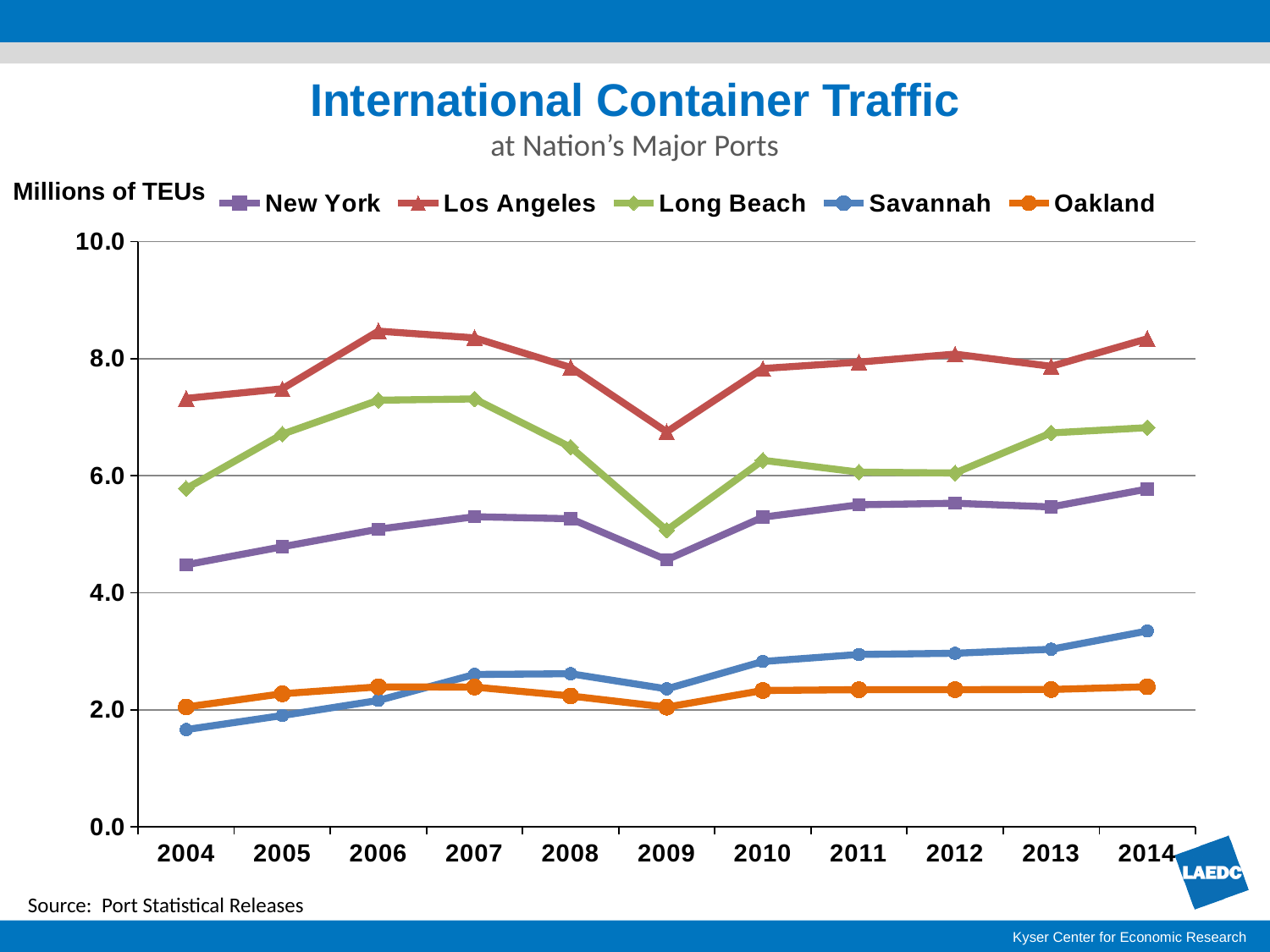
How many years are plotted along the x axis? 11 Does Savannah's container traffic rise or fall from 2009 to 2014? rise Which port had the highest container traffic in 2014? Los Angeles How many ports (series) does the legend list? 5 What is the source cited for the chart data? Port Statistical Releases Which port had the lowest container traffic in 2014? Oakland What unit is the y axis measured in? Millions of TEUs In 2014, which port had more container traffic, Savannah or Oakland? Savannah Is the value for Long Beach in 2009 greater or less than 6.0? less Which port had the lowest container traffic in 2004? Savannah Is the value for Los Angeles in 2006 greater or less than 8.0? greater What kind of chart is shown on the slide? line chart